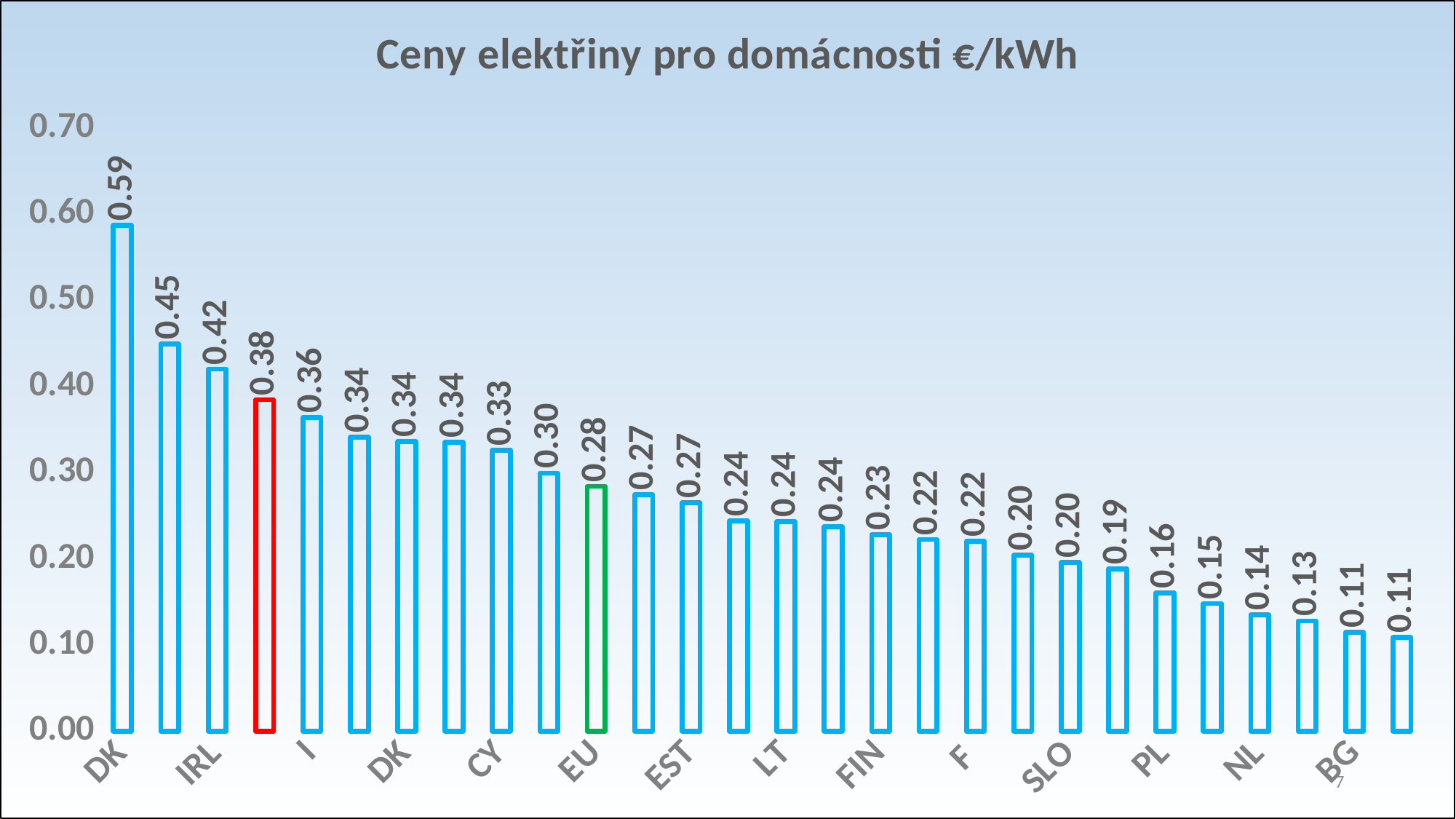
What is the value shown for CY? 0.33 What is the lowest value shown in the chart? 0.11 Do the values rise or fall from left to right along the x axis? fall What kind of chart is shown on the slide? bar chart What is the value shown for EU? 0.28 Which has the larger value, EST or FIN? EST What is the electricity price for IRL? 0.42 What is the value shown for PL? 0.16 How much higher is the value for IRL than the value for EU? 0.14 What is the title of the chart? Ceny elektřiny pro domácnosti €/kWh What is the highest value shown in the chart? 0.59 What colour is the bar for EU? green